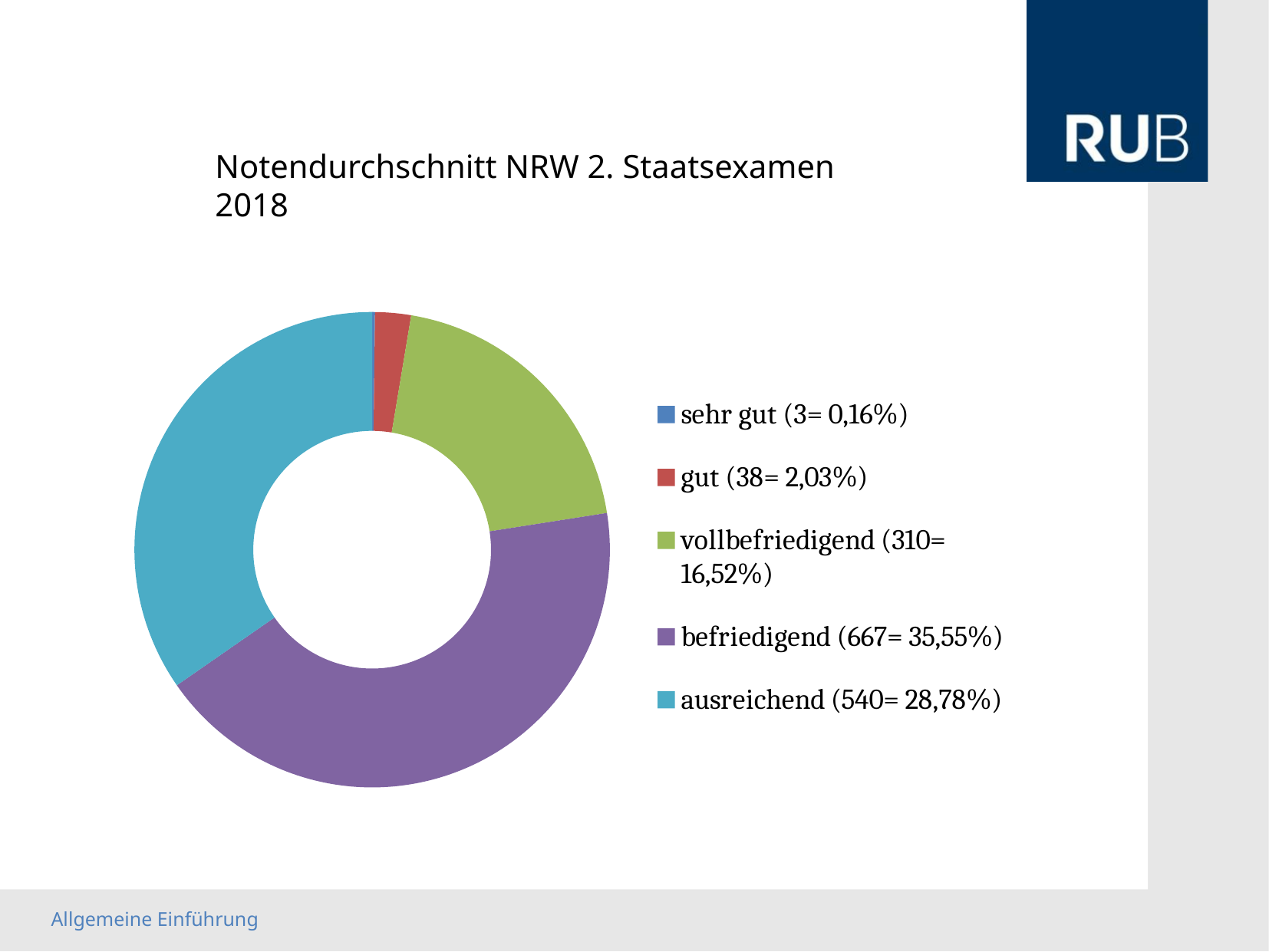
Which grade category has the smallest share of the chart? sehr gut What percentage is shown for 'vollbefriedigend'? 16,52% How many candidates received 'sehr gut'? 3 Which grade category has the largest share of the chart? befriedigend How many grade categories does the chart show? 5 What is the difference in the number of candidates between 'vollbefriedigend' and 'gut'? 272 What kind of chart is shown on the slide? doughnut chart What is the title of the chart? Notendurchschnitt NRW 2. Staatsexamen 2018 How many candidates received the grade 'befriedigend' according to the legend? 667 Which category has more candidates, 'ausreichend' or 'vollbefriedigend'? ausreichend What percentage is shown for 'ausreichend' in the legend? 28,78% What is the difference in the number of candidates between 'befriedigend' and 'ausreichend'? 127